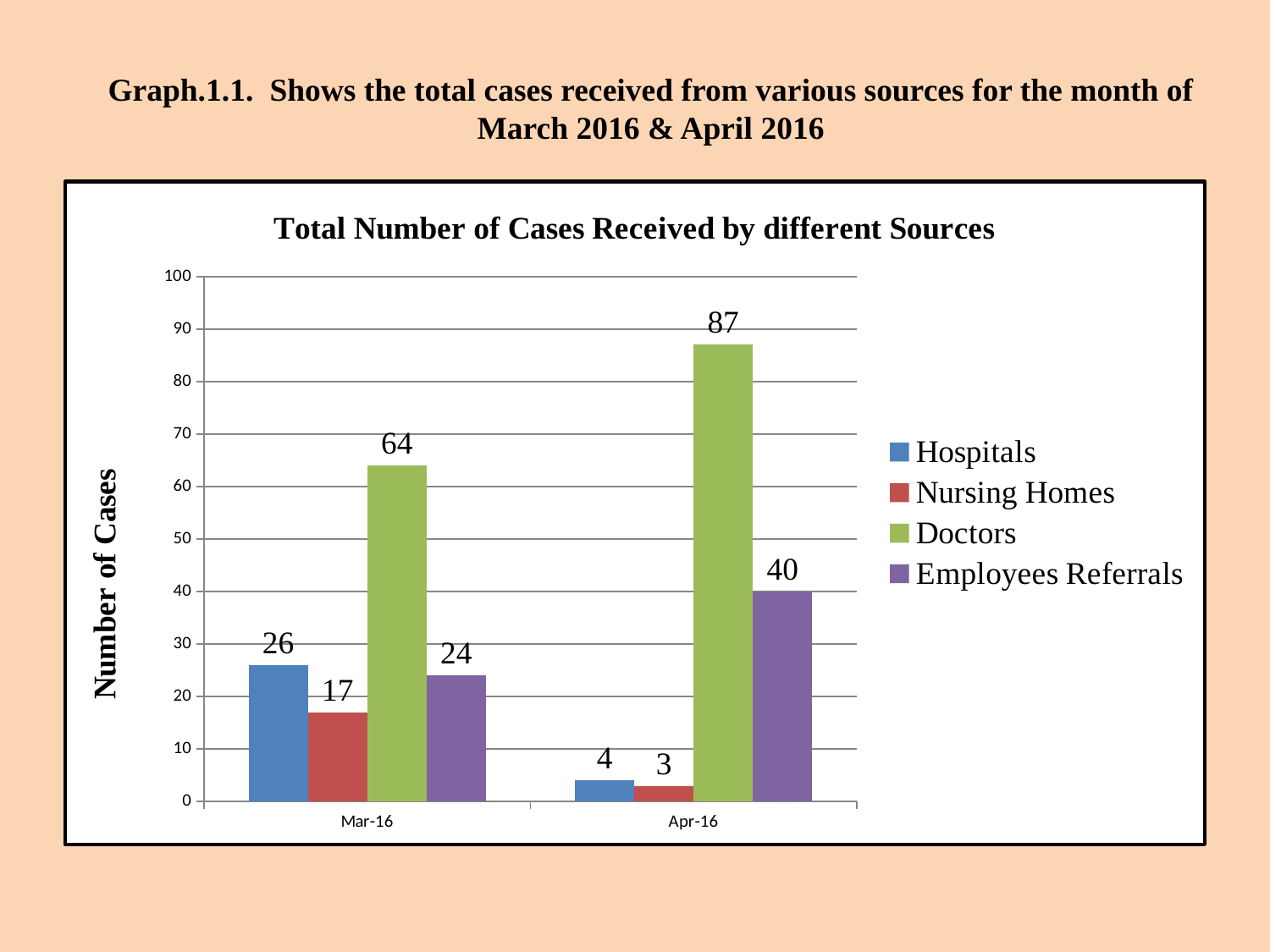
How many categories are shown on the x axis? 2 Which source has the lowest value in Apr-16? Nursing Homes Which is larger: Employees Referrals in Apr-16 or Hospitals in Mar-16? Employees Referrals in Apr-16 What is the value for Doctors in Apr-16? 87 Which source has the highest value in Mar-16? Doctors What is the difference between the Doctors values for Apr-16 and Mar-16? 23 What kind of chart is shown? Bar chart What is the value for Hospitals in Mar-16? 26 What is the value for Nursing Homes in Apr-16? 3 What is the value for Employees Referrals in Mar-16? 24 How many series does the legend list? 4 What is the title of the chart? Total Number of Cases Received by different Sources